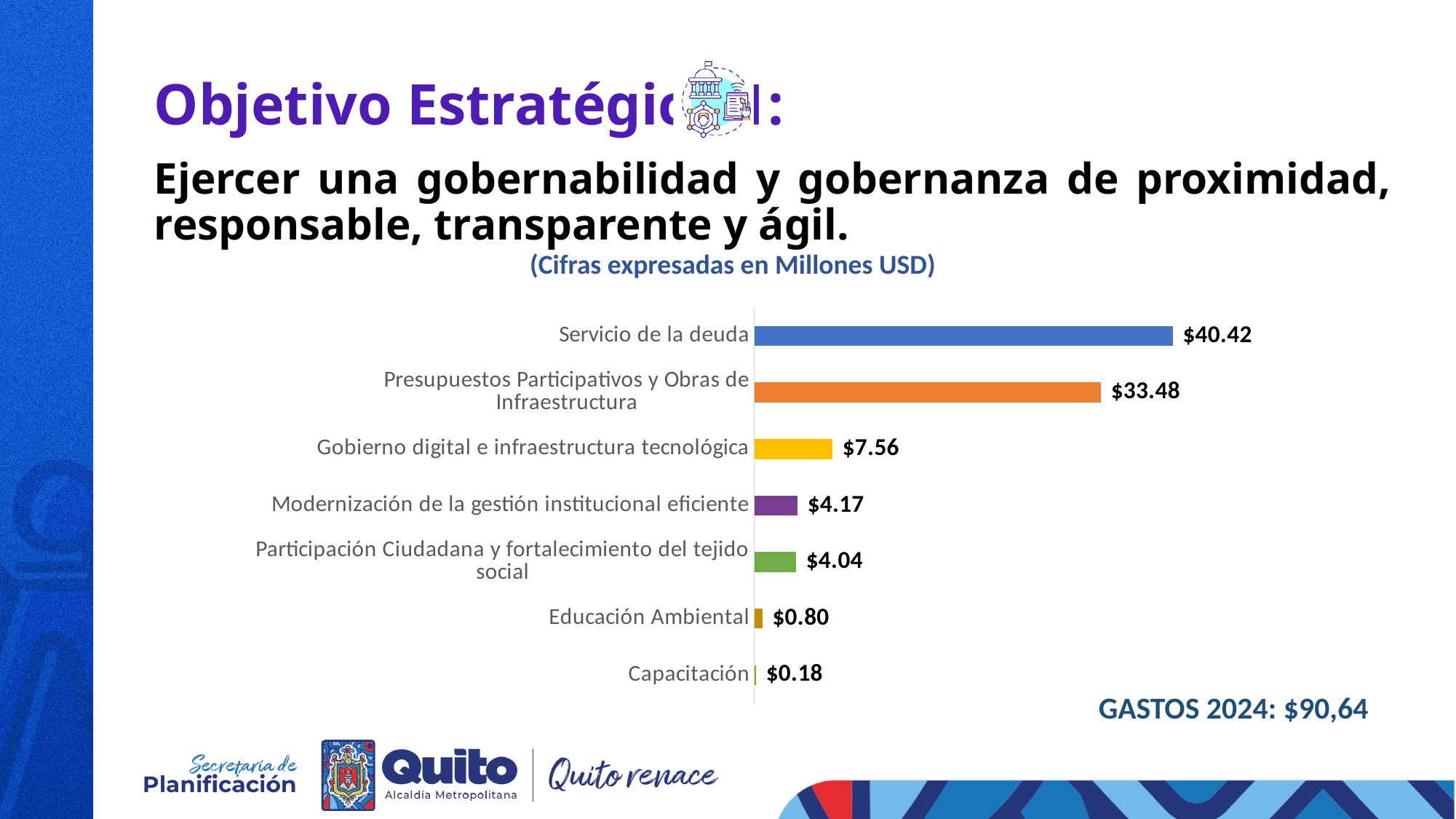
Which is larger, Modernización de la gestión institucional eficiente or Participación Ciudadana y fortalecimiento del tejido social? Modernización de la gestión institucional eficiente How many categories are shown in the chart? 7 What kind of chart is shown on the slide? Bar chart In what units are the figures in the chart expressed, according to the slide? Millones USD What is the difference between Gobierno digital e infraestructura tecnológica and Modernización de la gestión institucional eficiente? $3.39 What is the value for Presupuestos Participativos y Obras de Infraestructura? $33.48 What is the difference between Servicio de la deuda and Presupuestos Participativos y Obras de Infraestructura? $6.94 Which category has the lowest value? Capacitación What is the value for Servicio de la deuda? $40.42 What is the value for Educación Ambiental? $0.80 Which category has the highest value? Servicio de la deuda What is the value for Gobierno digital e infraestructura tecnológica? $7.56